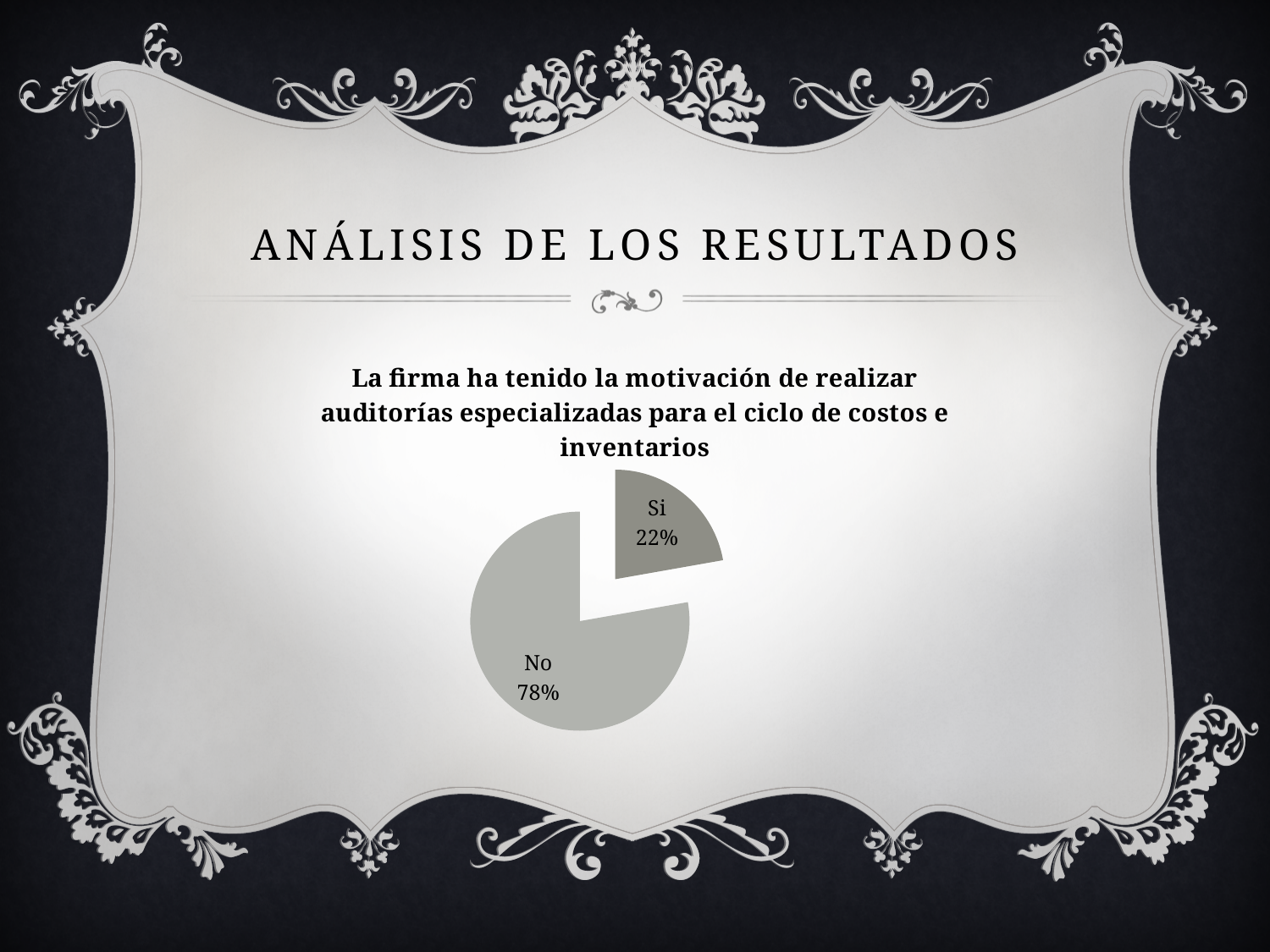
Which slice of the pie chart is the smallest? Si Which slice of the pie chart is the largest? No What percentage of the pie chart is labelled "No"? 78% How many slices does the pie chart have? 2 What share of the pie does the "Si" slice represent? 22% Is the "No" slice greater or less than 50% of the pie? greater What kind of chart is shown on the slide? Pie chart Which slice is larger, "Si" or "No"? No What percentage of the pie chart is labelled "Si"? 22% What is the difference in percentage points between the "No" slice and the "Si" slice? 56 What is the title of the chart? La firma ha tenido la motivación de realizar auditorías especializadas para el ciclo de costos e inventarios